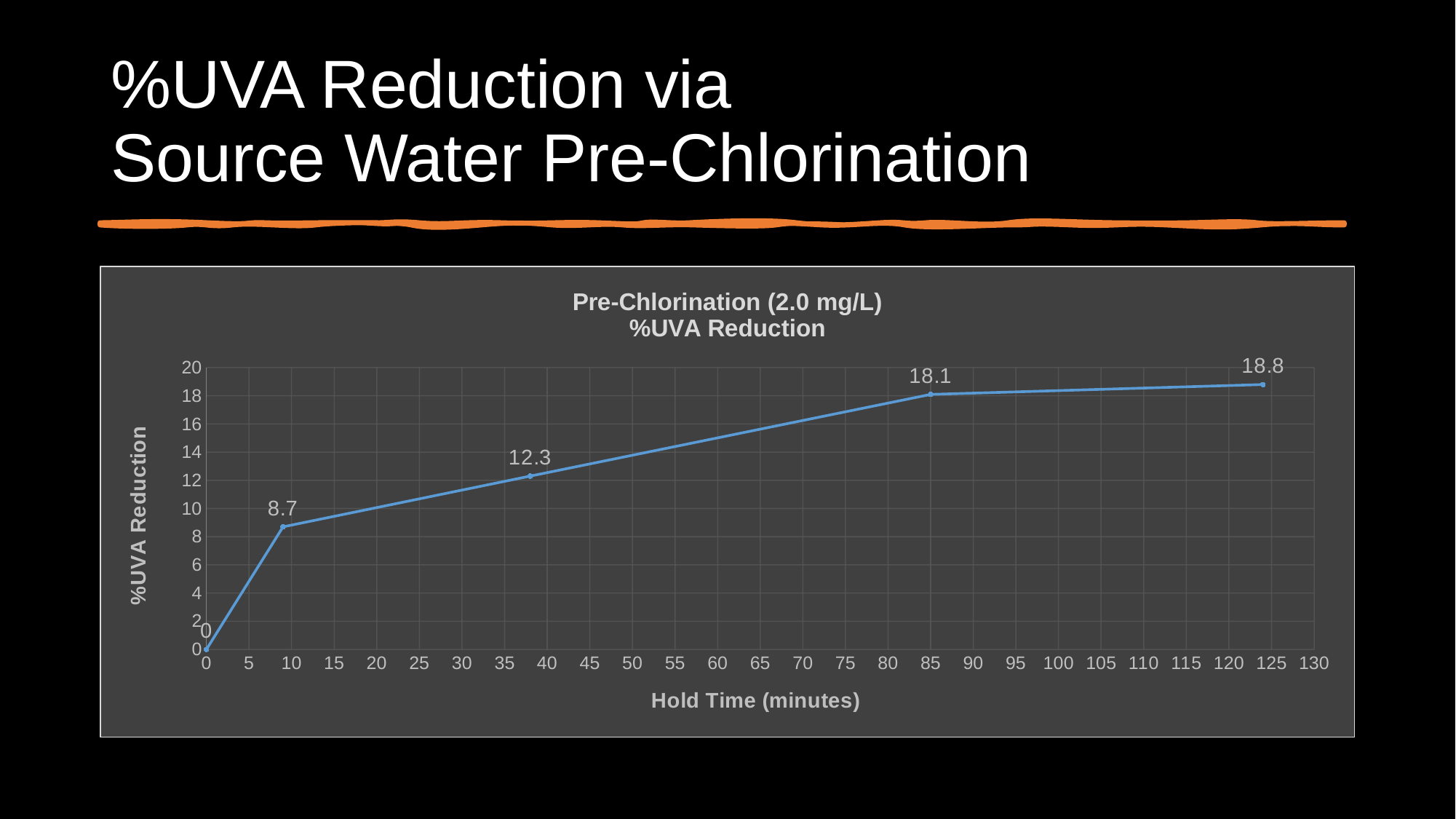
What is the difference between the last data point (18.8) and the fourth data point (18.1)? 0.7 What is the title of the chart? Pre-Chlorination (2.0 mg/L) %UVA Reduction How many data points are plotted on the line? 5 What is the %UVA Reduction value of the third data point on the line? 12.3 What is the difference between the data points labelled 12.3 and 8.7? 3.6 What is the %UVA Reduction value of the second data point on the line? 8.7 Is the %UVA Reduction value of the fourth data point greater or less than 16? greater What is the lowest %UVA Reduction value labelled on the chart? 0 Does %UVA Reduction rise or fall as hold time increases? rise What kind of chart is shown on the slide? line chart What is the label of the x axis? Hold Time (minutes) What is the highest %UVA Reduction value labelled on the chart? 18.8